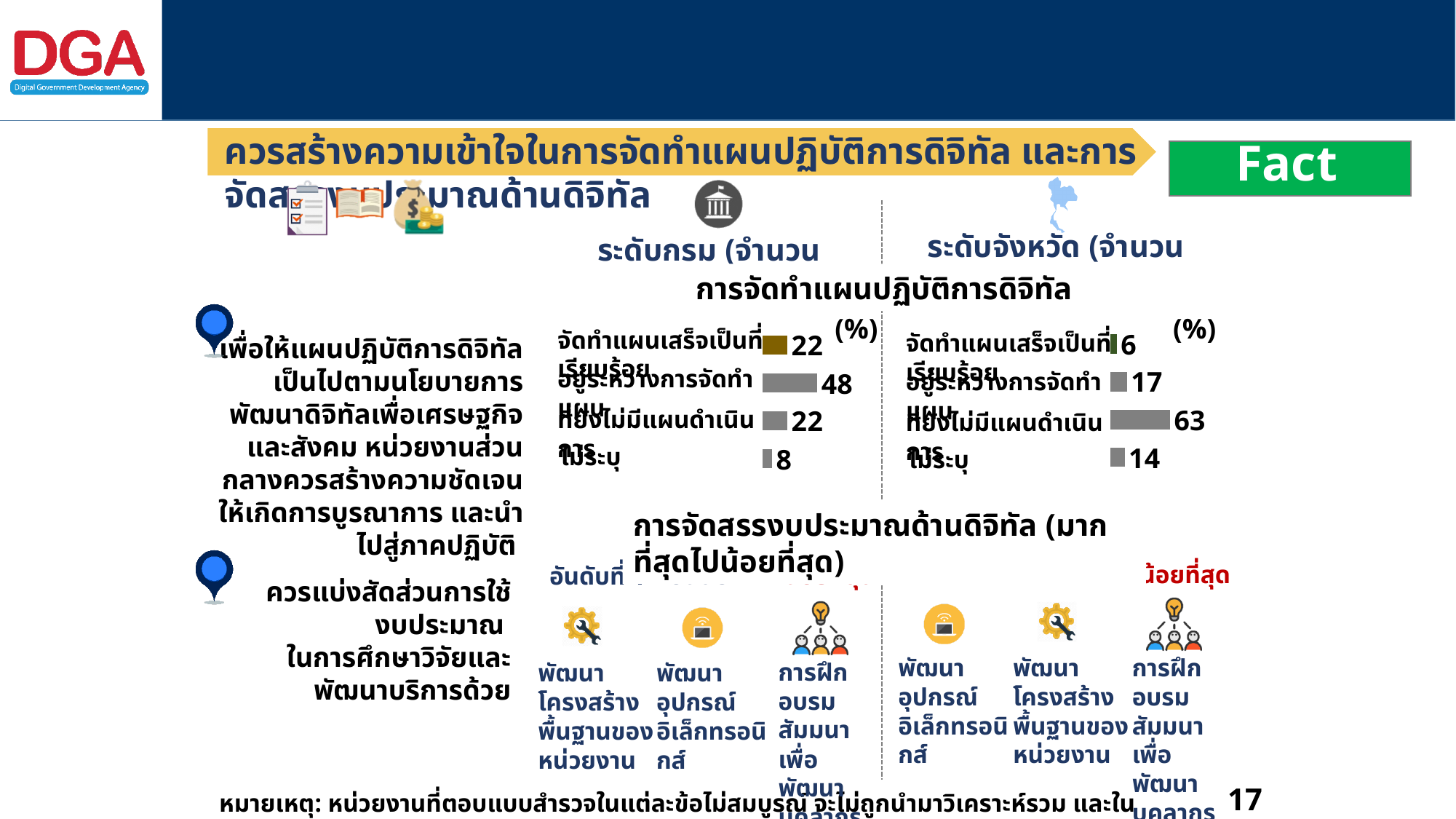
In the department-level chart (ระดับกรม), which category has the highest value? อยู่ระหว่างการจัดทำแผน What unit is shown for the values in the การจัดทำแผนปฏิบัติการดิจิทัล charts? % Which is larger: ยังไม่มีแผนดำเนินการ in the department-level chart or ยังไม่มีแผนดำเนินการ in the province-level chart? province-level chart (ระดับจังหวัด) How many categories does the department-level chart (ระดับกรม) show? 4 What type of chart is used for การจัดทำแผนปฏิบัติการดิจิทัล at the department level? bar chart In the province-level chart (ระดับจังหวัด), what is the difference between ยังไม่มีแผนดำเนินการ and อยู่ระหว่างการจัดทำแผน? 46 In the department-level chart (ระดับกรม), what is the difference between อยู่ระหว่างการจัดทำแผน and ไม่ระบุ? 40 In the province-level chart (ระดับจังหวัด), what is the value for จัดทำแผนเสร็จเป็นที่เรียบร้อย? 6 In the province-level chart (ระดับจังหวัด), which category has the lowest value? จัดทำแผนเสร็จเป็นที่เรียบร้อย In the province-level chart (ระดับจังหวัด), what is the value for ยังไม่มีแผนดำเนินการ? 63 In the department-level chart (ระดับกรม), what is the value for ไม่ระบุ? 8 In the department-level chart (ระดับกรม), what is the value for อยู่ระหว่างการจัดทำแผน? 48